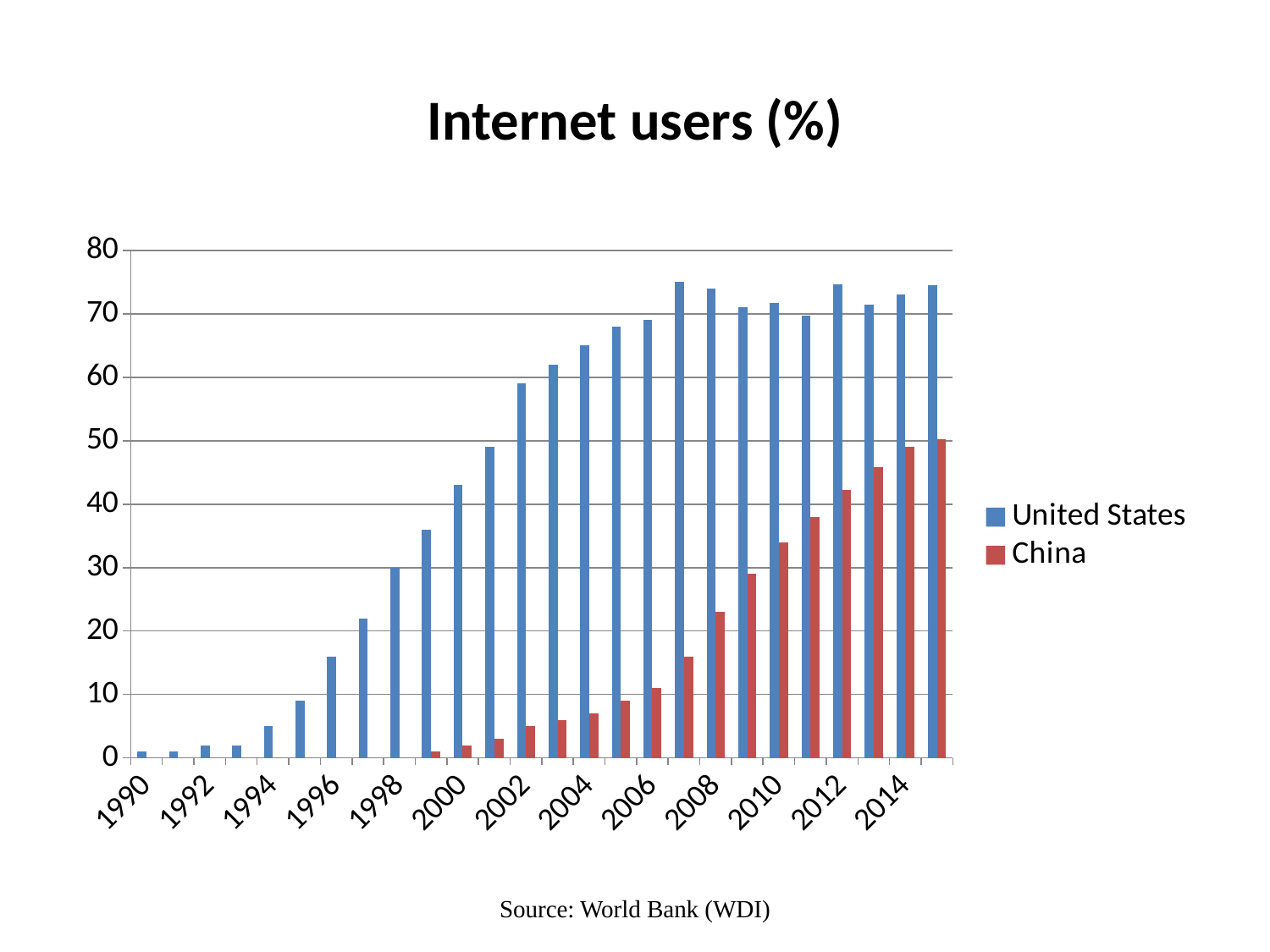
Which is larger in 2010, the value for the United States or the value for China? United States In which year is the value for China highest? 2015 Is the value for China in 2012 greater or less than 40? greater Is the value for the United States in 2008 greater or less than 70? greater What is the title of the chart? Internet users (%) Which series is shown in red? China Is the value for the United States in 2004 greater or less than 60? greater What kind of chart is shown on the slide? bar chart How many series does the legend list? 2 Do the values for China rise or fall over the years shown? rise